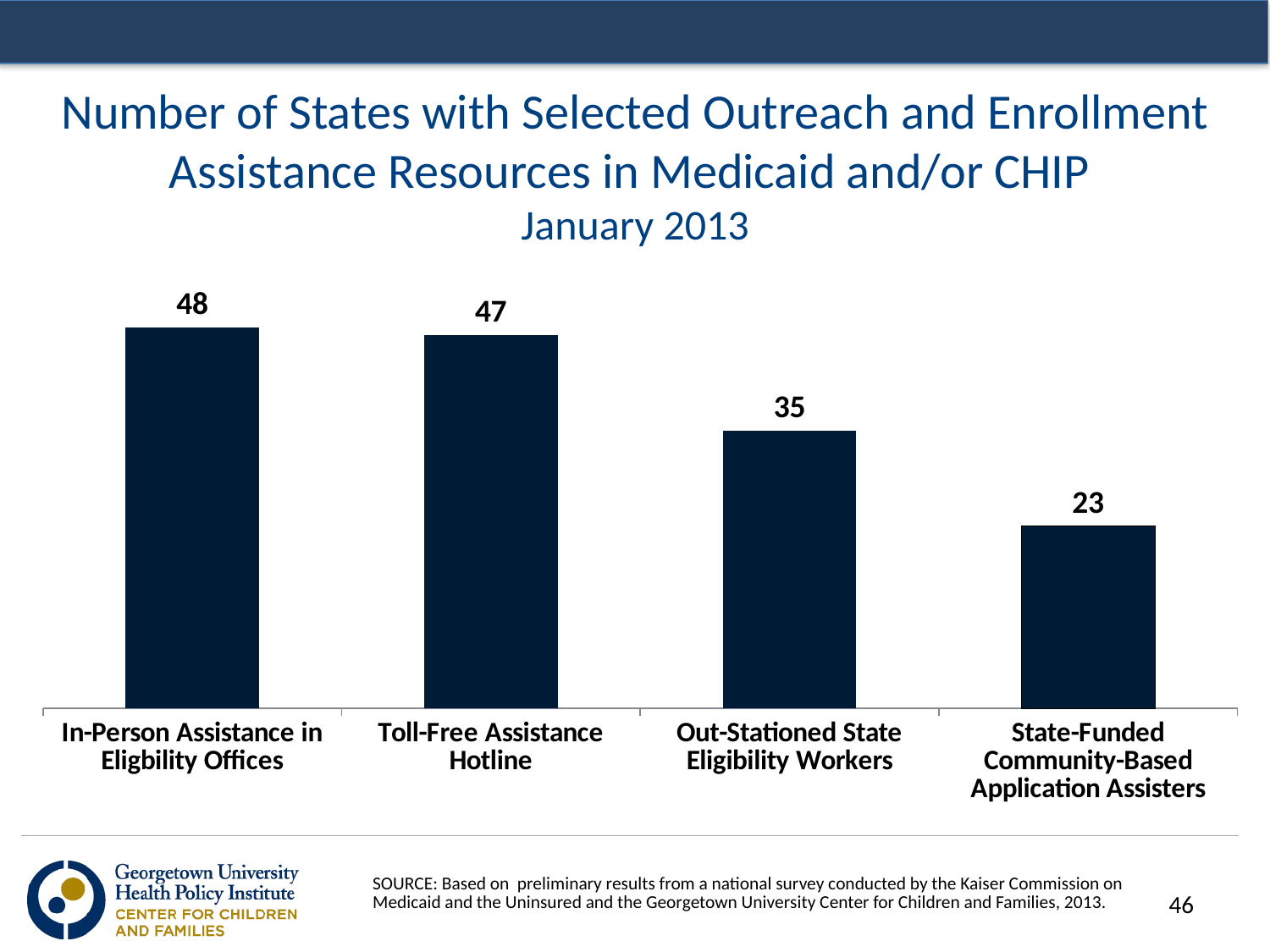
How many categories are shown in the chart? 4 Which is larger: the value for Out-Stationed State Eligibility Workers or State-Funded Community-Based Application Assisters? Out-Stationed State Eligibility Workers What is the difference between the values for In-Person Assistance in Eligibility Offices and State-Funded Community-Based Application Assisters? 25 What is the value for State-Funded Community-Based Application Assisters? 23 What is the value for Toll-Free Assistance Hotline? 47 How many states have In-Person Assistance in Eligibility Offices? 48 What is the difference between the values for Toll-Free Assistance Hotline and Out-Stationed State Eligibility Workers? 12 Which category has the lowest number of states? State-Funded Community-Based Application Assisters How many states have Out-Stationed State Eligibility Workers? 35 Do the values rise or fall from left to right across the categories? Fall Which category has the highest number of states? In-Person Assistance in Eligibility Offices What kind of chart is shown on the slide? Bar chart